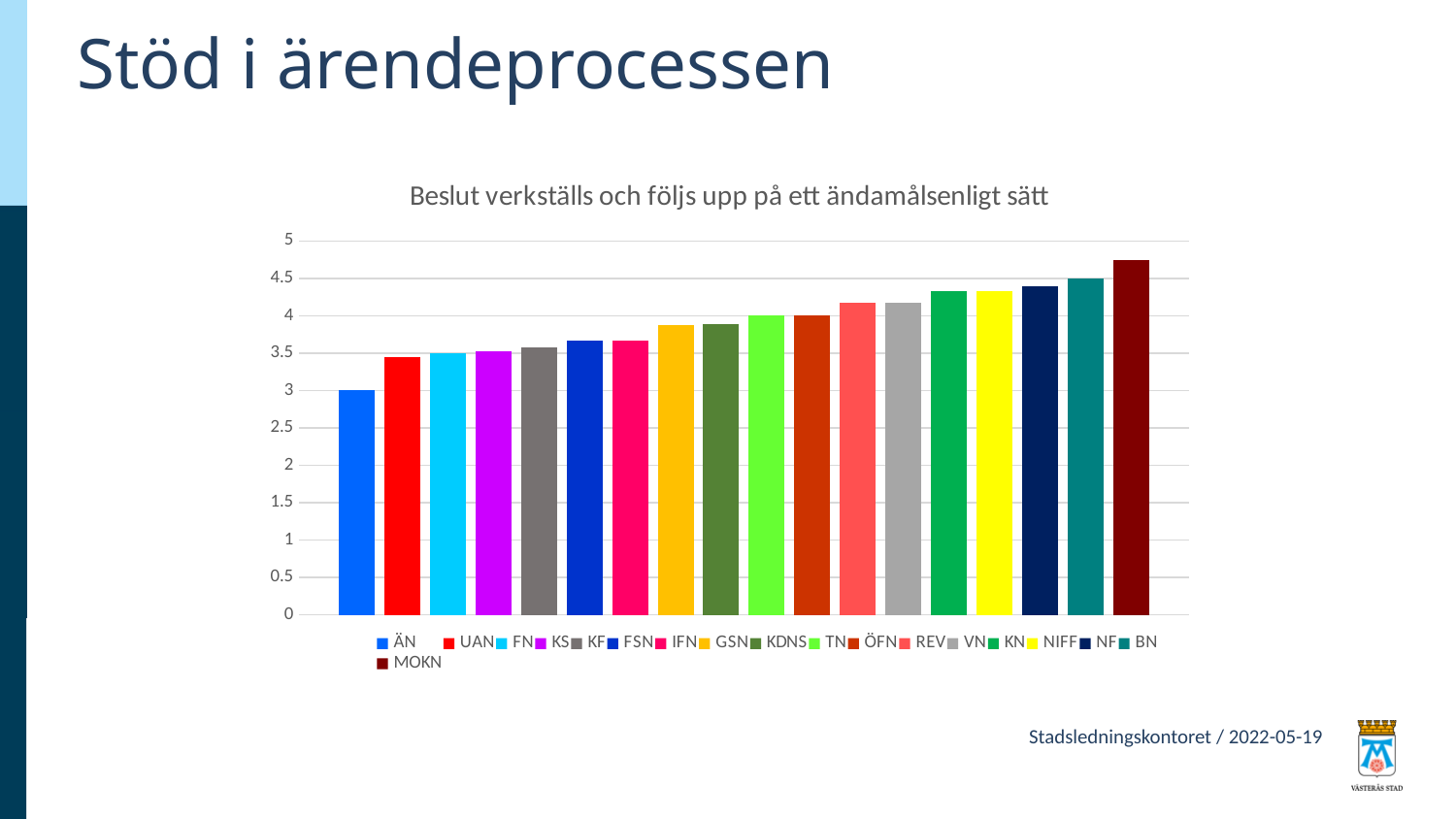
How many bars are plotted in the chart? 18 Which category has the highest value? MOKN Do the values rise or fall from left to right along the x axis? rise Is the value for MOKN greater or less than 4.5? greater Which category has the lowest value? ÄN Is the value for KN greater or less than 4? greater What is the title of the chart? Beslut verkställs och följs upp på ett ändamålsenligt sätt What kind of chart is shown on the slide? bar chart Is the value for ÄN greater or less than 3.5? less Which is larger, the value for BN or the value for UAN? BN How many entries does the legend list? 18 Which is larger, the value for ÄN or the value for REV? REV